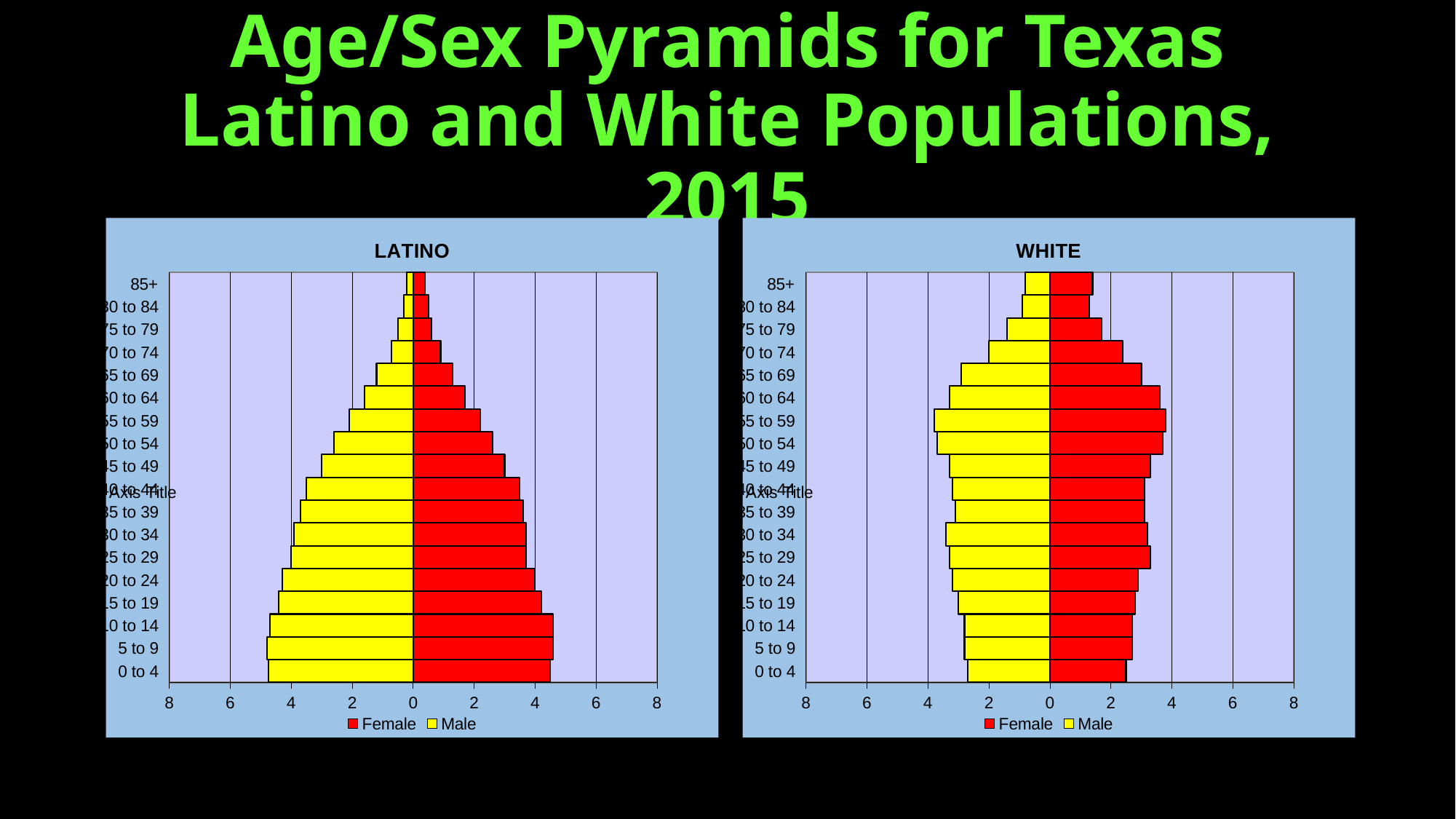
In the WHITE chart, is the Male value for 0 to 4 greater or less than 2? greater Which chart has the larger Female value for 0 to 4, LATINO or WHITE? LATINO In the LATINO chart, is the Female value for 0 to 4 greater or less than 4? greater What kind of chart is the LATINO chart? bar chart In the WHITE chart, which is larger for 85+, the Female value or the Male value? Female In the LATINO chart, is the Male value for 85+ greater or less than 2? less In the LATINO chart, which age group has the smallest Female value? 85+ How many series does the legend of the WHITE chart list? 2 In the LATINO chart, do the bars get longer or shorter as the age groups get older? shorter How many age groups are shown on the LATINO chart? 18